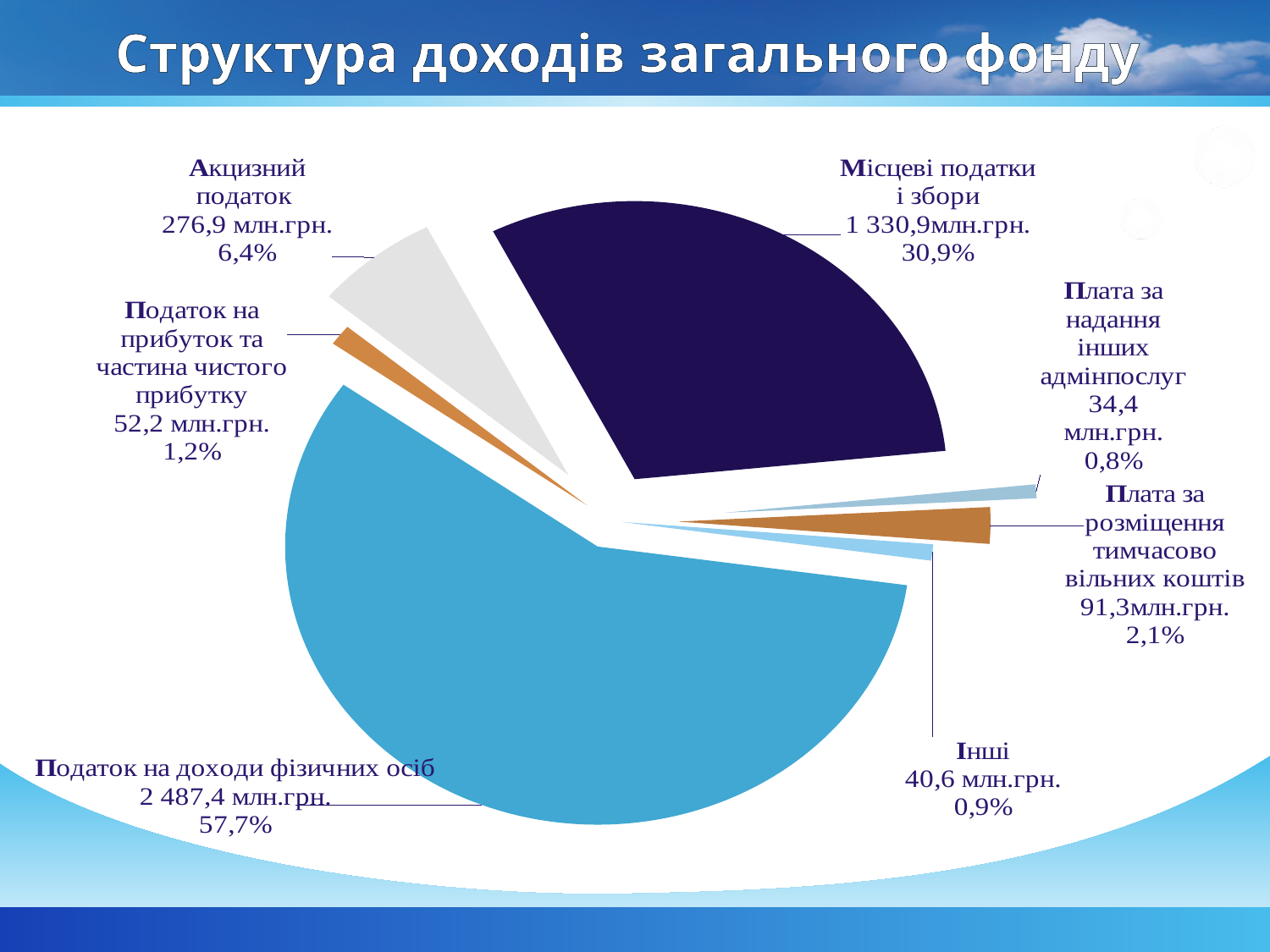
What is the title of the chart? Структура доходів загального фонду Which category has the smallest slice of the pie? Плата за надання інших адмінпослуг How many slices does the pie chart have? 7 What is the value shown for Інші? 40,6 млн.грн. What is the difference in percentage share between Податок на доходи фізичних осіб and Місцеві податки і збори? 26,8% What share of the pie is Плата за розміщення тимчасово вільних коштів? 2,1% What kind of chart is shown on the slide? pie chart Which is larger: Акцизний податок or Інші? Акцизний податок Which category has the largest slice of the pie? Податок на доходи фізичних осіб What share of the pie is Податок на доходи фізичних осіб? 57,7% What is the value shown for Акцизний податок? 276,9 млн.грн. What is the value shown for Місцеві податки і збори? 1 330,9 млн.грн.